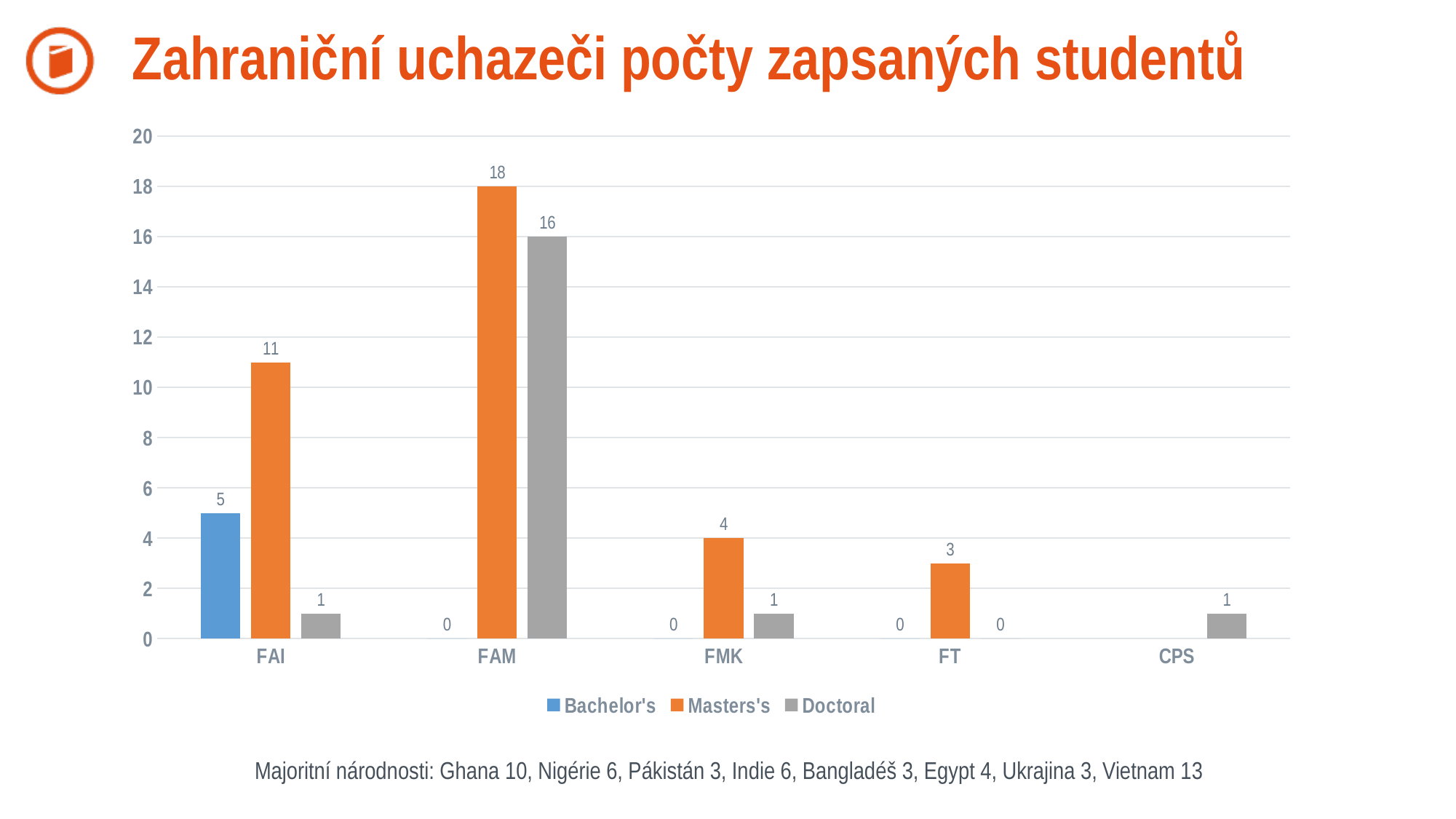
Which faculty has the highest Masters's value? FAM Which is larger for FAM: the Masters's value or the Doctoral value? Masters's What is the Doctoral value for FAM? 16 What is the Masters's value for FT? 3 How many faculties are shown on the x axis? 5 What is the Bachelor's value for FAI? 5 How many series does the legend list? 3 What is the total of the Bachelor's, Masters's and Doctoral values for FMK? 5 Which faculty has the lowest Masters's value? FT What is the difference between the Masters's and Doctoral values for FAI? 10 What is the Masters's value for FAM? 18 What kind of chart is shown on the slide? Bar chart